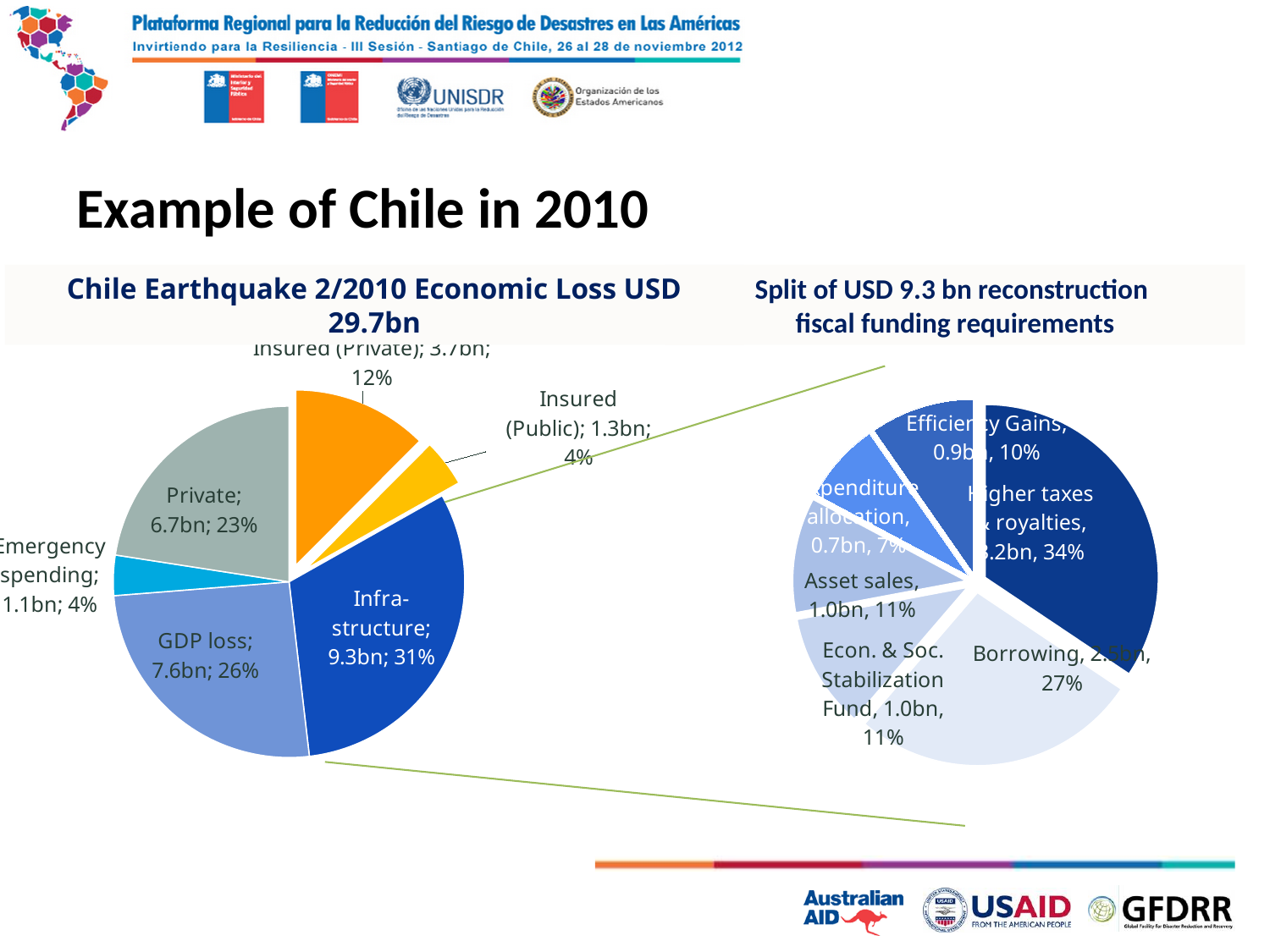
In the 'Chile Earthquake 2/2010 Economic Loss USD 29.7bn' chart, what is the value for Infrastructure? 9.3bn; 31% In the 'Chile Earthquake 2/2010 Economic Loss USD 29.7bn' chart, what is the difference in billions between Private and Insured (Private)? 3.0bn How many slices does the 'Split of USD 9.3 bn reconstruction fiscal funding requirements' pie chart have? 6 In the 'Split of USD 9.3 bn reconstruction fiscal funding requirements' chart, what share does Borrowing represent? 27% In the 'Split of USD 9.3 bn reconstruction fiscal funding requirements' chart, what share does Efficiency Gains represent? 10% How many slices does the 'Chile Earthquake 2/2010 Economic Loss USD 29.7bn' pie chart have? 6 In the 'Chile Earthquake 2/2010 Economic Loss USD 29.7bn' chart, which category has the largest share? Infrastructure In the 'Chile Earthquake 2/2010 Economic Loss USD 29.7bn' chart, what is the value for GDP loss? 7.6bn; 26% In the 'Chile Earthquake 2/2010 Economic Loss USD 29.7bn' chart, which is larger, GDP loss or Private? GDP loss In the 'Split of USD 9.3 bn reconstruction fiscal funding requirements' chart, which category has the largest share? Higher taxes & royalties In the 'Split of USD 9.3 bn reconstruction fiscal funding requirements' chart, what is the value for Asset sales? 1.0bn, 11% What type of chart is the 'Chile Earthquake 2/2010 Economic Loss USD 29.7bn' chart? Pie chart